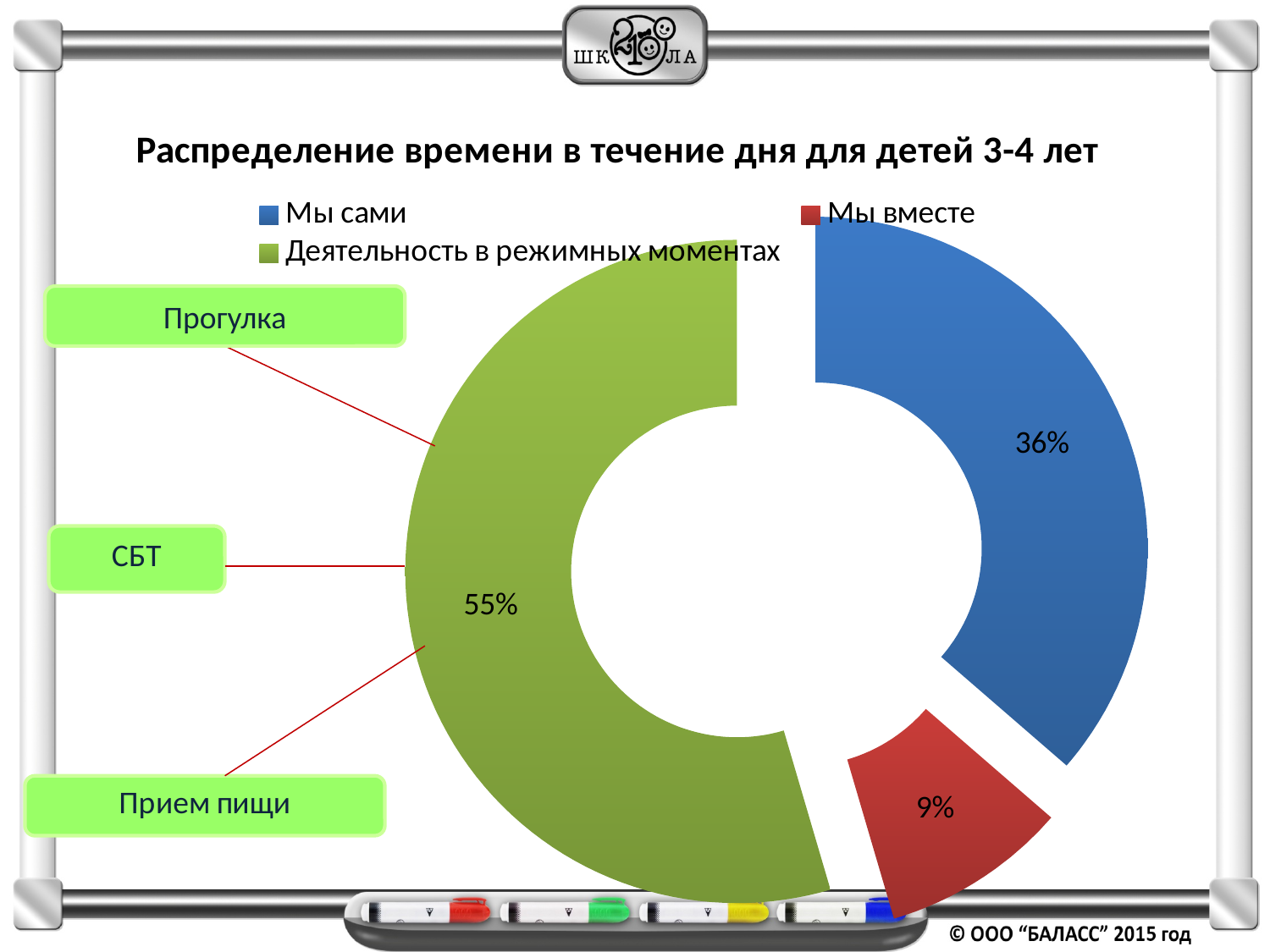
How many categories does the chart show? 3 What is the title of the chart? Распределение времени в течение дня для детей 3-4 лет Which category has the smallest share of the chart? Мы вместе What colour represents "Мы вместе" in the chart? Red What percentage is shown for "Мы вместе"? 9% Which category has the largest share of the chart? Деятельность в режимных моментах What percentage is shown for "Деятельность в режимных моментах"? 55% What is the difference in percentage points between "Деятельность в режимных моментах" and "Мы сами"? 19 How many entries does the legend list? 3 Which is larger, the share for "Мы сами" or the share for "Мы вместе"? Мы сами What kind of chart is shown on the slide? Doughnut chart What percentage is shown for "Мы сами"? 36%